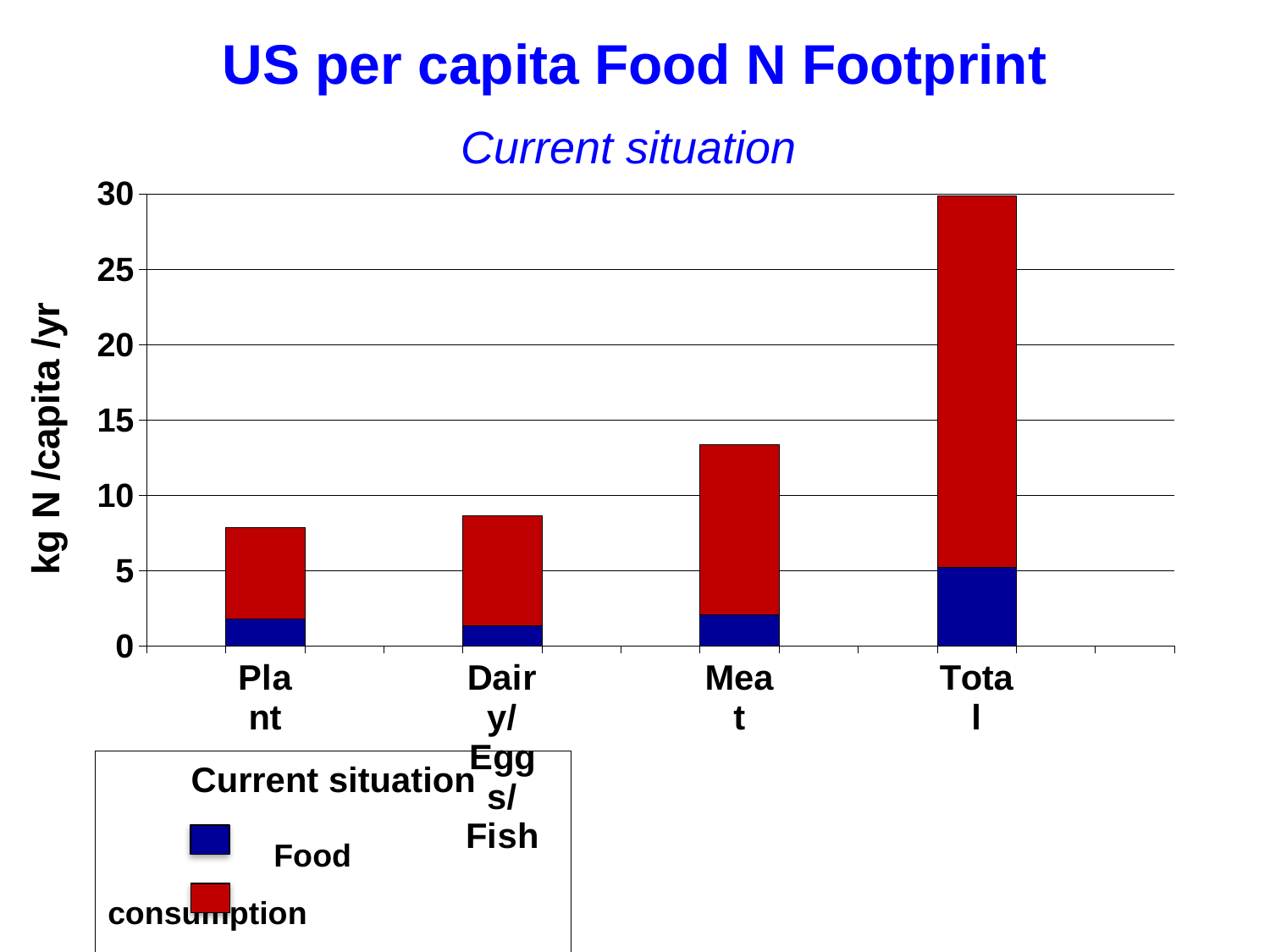
What is the title of the chart on the slide? US per capita Food N Footprint How many series does the chart's legend list? 2 Is the total bar for Meat greater or less than 10 kg N /capita /yr? greater How many categories are shown on the x axis of the chart? 4 What kind of chart is shown on the slide? stacked bar chart Is the total bar for Dairy/Eggs/Fish greater or less than 5 kg N /capita /yr? greater Is the total bar for Total greater or less than 25 kg N /capita /yr? greater Which category has the highest total bar? Total Which has a taller total bar, Meat or Dairy/Eggs/Fish? Meat What is the label on the y axis of the chart? kg N /capita /yr